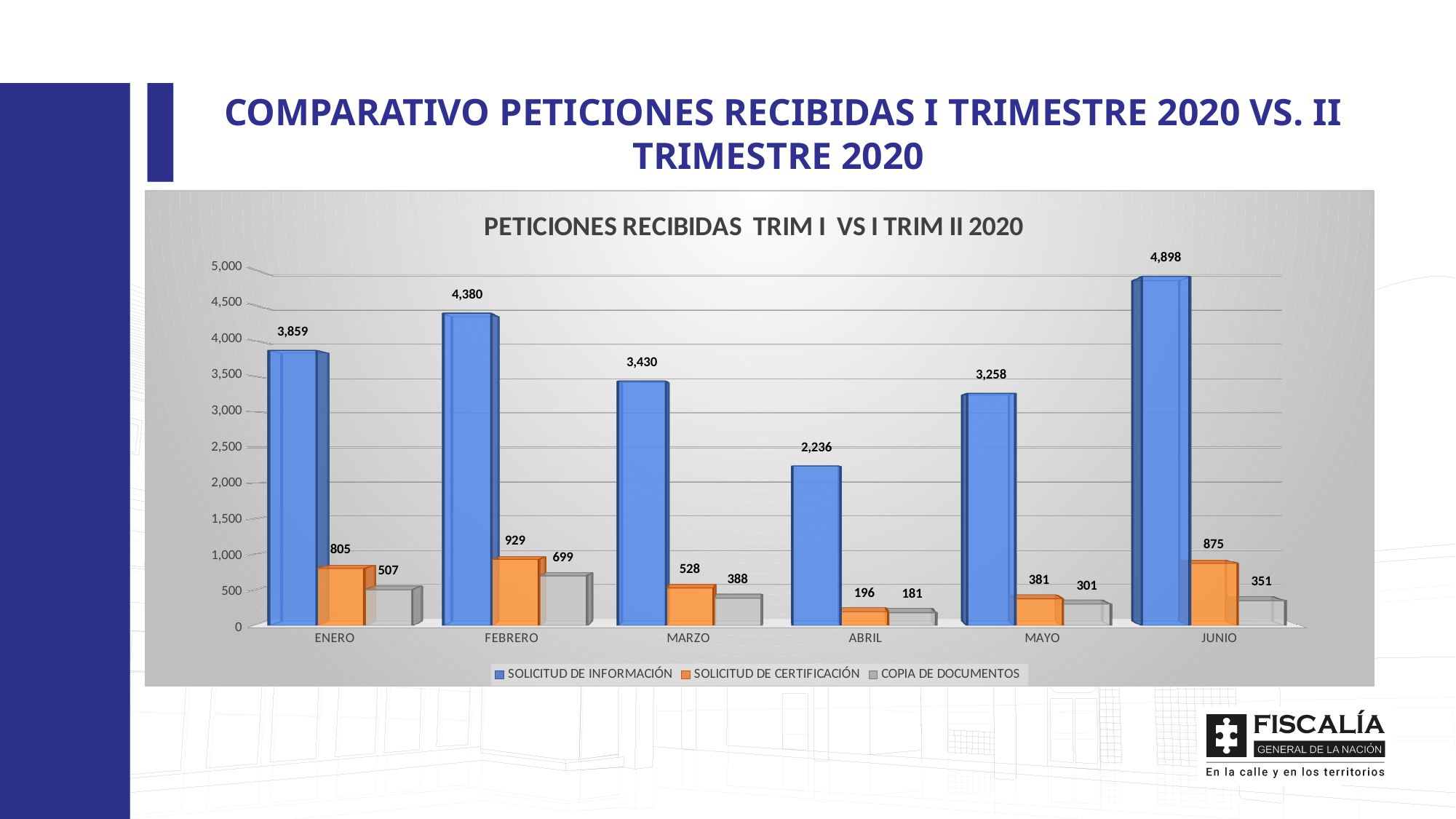
What kind of chart is shown? Bar chart Which is larger: COPIA DE DOCUMENTOS in FEBRERO or in MARZO? FEBRERO Which month has the highest value for SOLICITUD DE INFORMACIÓN? JUNIO Is the value of SOLICITUD DE INFORMACIÓN for MAYO greater or less than 3,000? greater What is the value of COPIA DE DOCUMENTOS for ABRIL? 181 How many series does the legend list? 3 What is the difference between SOLICITUD DE INFORMACIÓN in JUNIO and in ABRIL? 2,662 What is the value of SOLICITUD DE CERTIFICACIÓN for FEBRERO? 929 What is the value of SOLICITUD DE INFORMACIÓN for JUNIO? 4,898 How many months are shown on the x axis? 6 What is the title of the chart? PETICIONES RECIBIDAS TRIM I VS I TRIM II 2020 Which month has the lowest value for SOLICITUD DE CERTIFICACIÓN? ABRIL